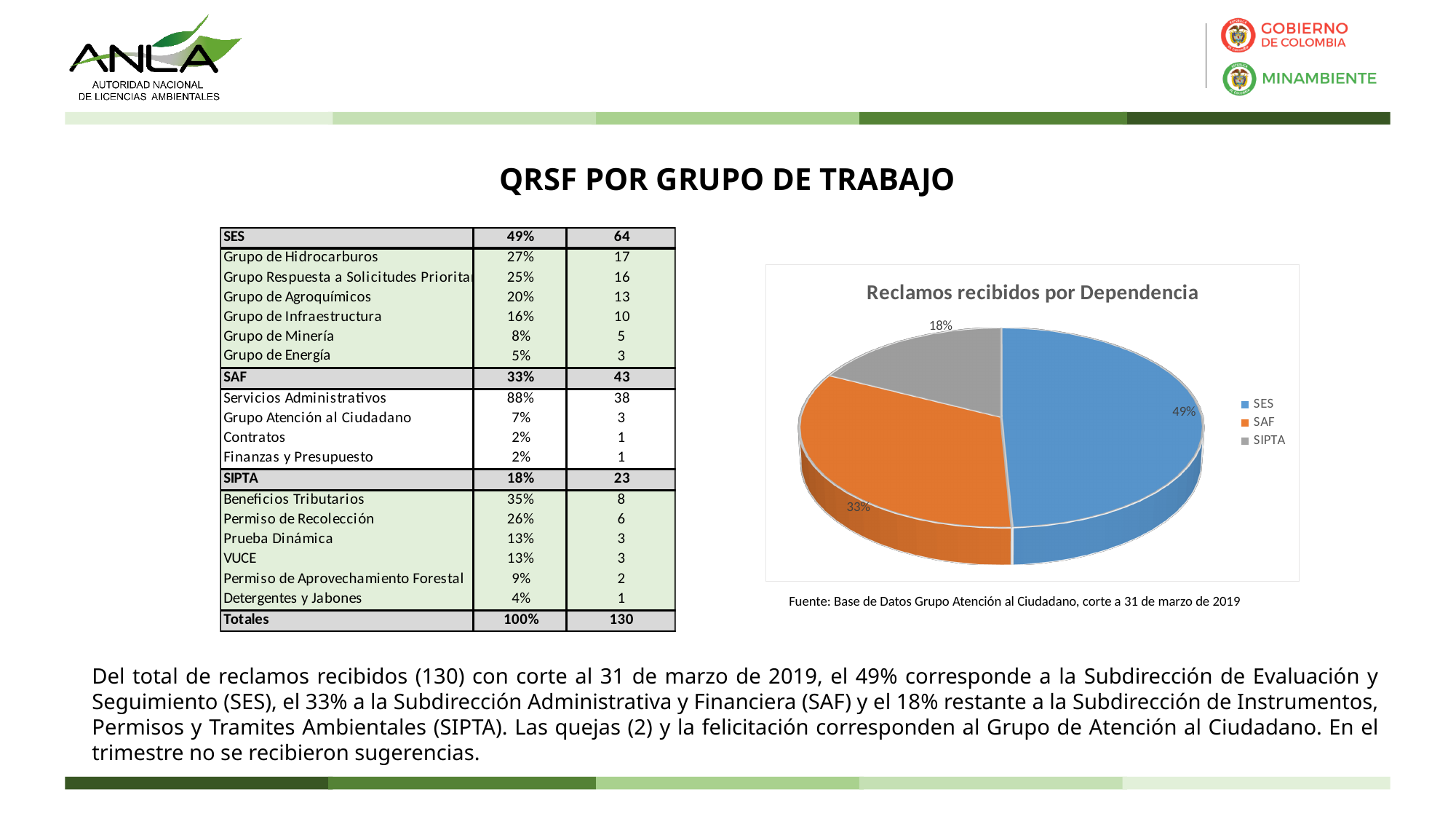
How many entries does the legend of the pie chart list? 3 What kind of chart is "Reclamos recibidos por Dependencia"? pie chart What is the title of the chart on the slide? Reclamos recibidos por Dependencia How many slices does the pie chart have? 3 Which slice is larger, SAF or SIPTA? SAF What share of the pie does SIPTA represent? 18% Which dependencia has the smallest slice of the pie? SIPTA Which colour is used for the SAF slice in the pie chart? orange What share of the pie does SAF represent? 33% Which dependencia has the largest slice of the pie? SES What share of the pie does SES represent? 49% What is the difference in percentage points between the SES and SAF slices? 16